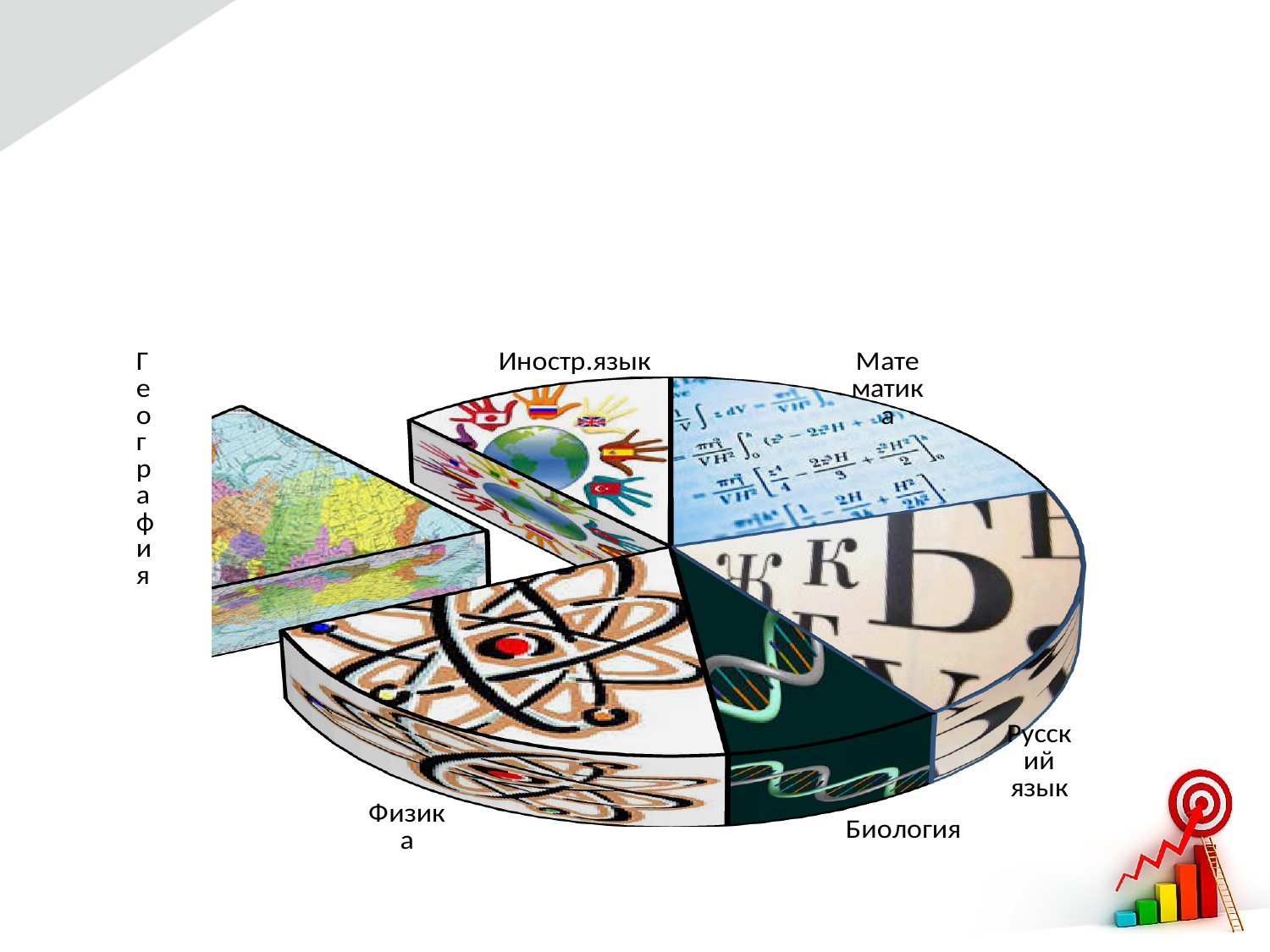
Which slice of the pie chart lies between Математика and Биология going clockwise? Русский язык Which slice of the pie chart is pulled out (exploded) from the rest of the pie? География Which slice of the pie chart is decorated with a world map image? География Which slice of the pie chart is larger, Физика or Биология? Физика What kind of chart is shown on the slide? pie chart How many slices does the pie chart have? 6